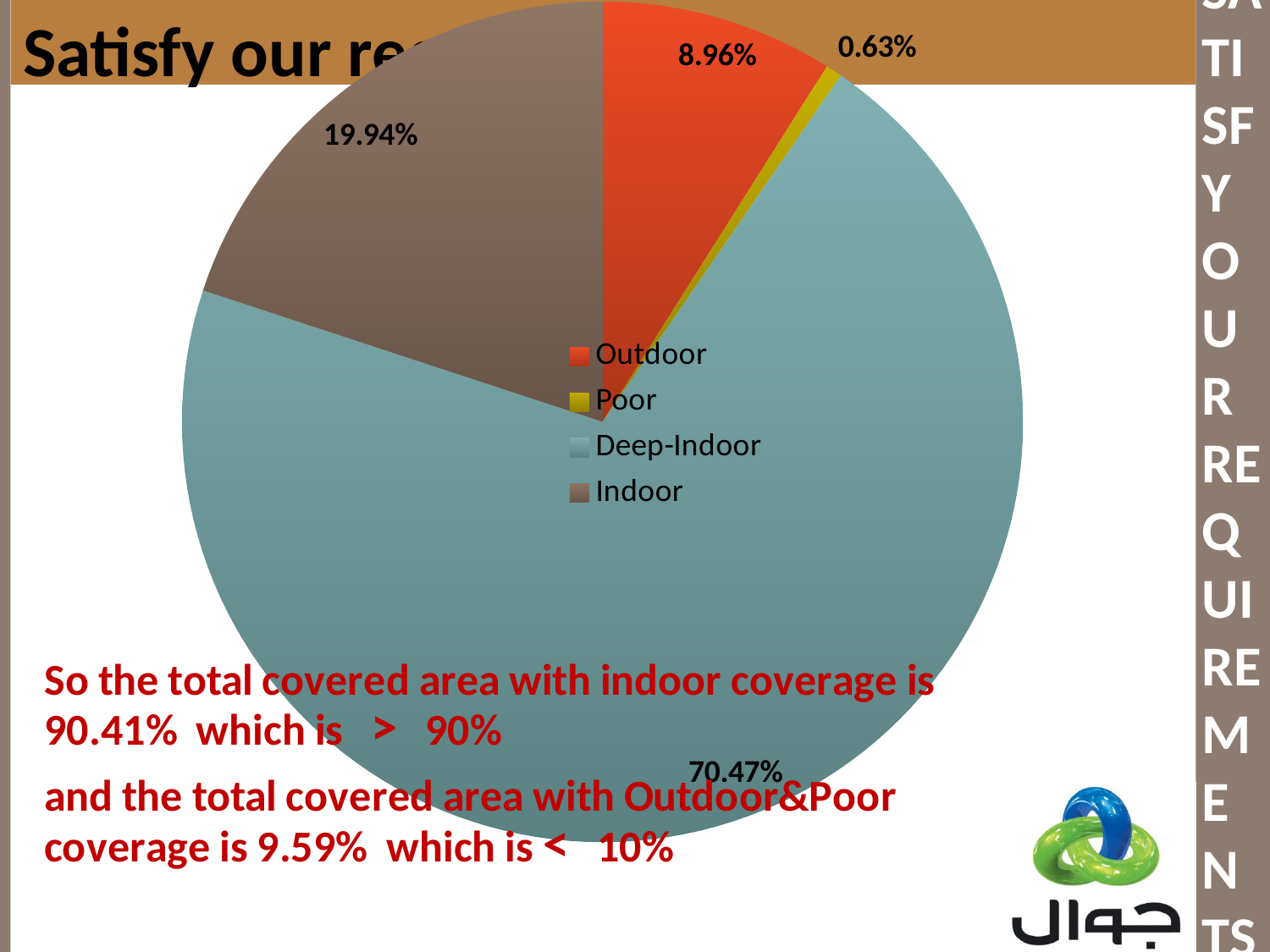
What percentage does the Poor slice show? 0.63% What percentage does the Indoor slice show? 19.94% What percentage does the Deep-Indoor slice show? 70.47% Which is larger, the Indoor slice or the Outdoor slice? Indoor Which category has the smallest slice of the pie? Poor What is the difference between the Indoor and Outdoor percentages? 10.98% What percentage does the Outdoor slice show? 8.96% How many slices does the pie chart have? 4 What colour is the Poor slice in the pie chart? yellow What kind of chart is shown on the slide? pie chart Which category has the largest slice of the pie? Deep-Indoor How many entries does the legend list? 4